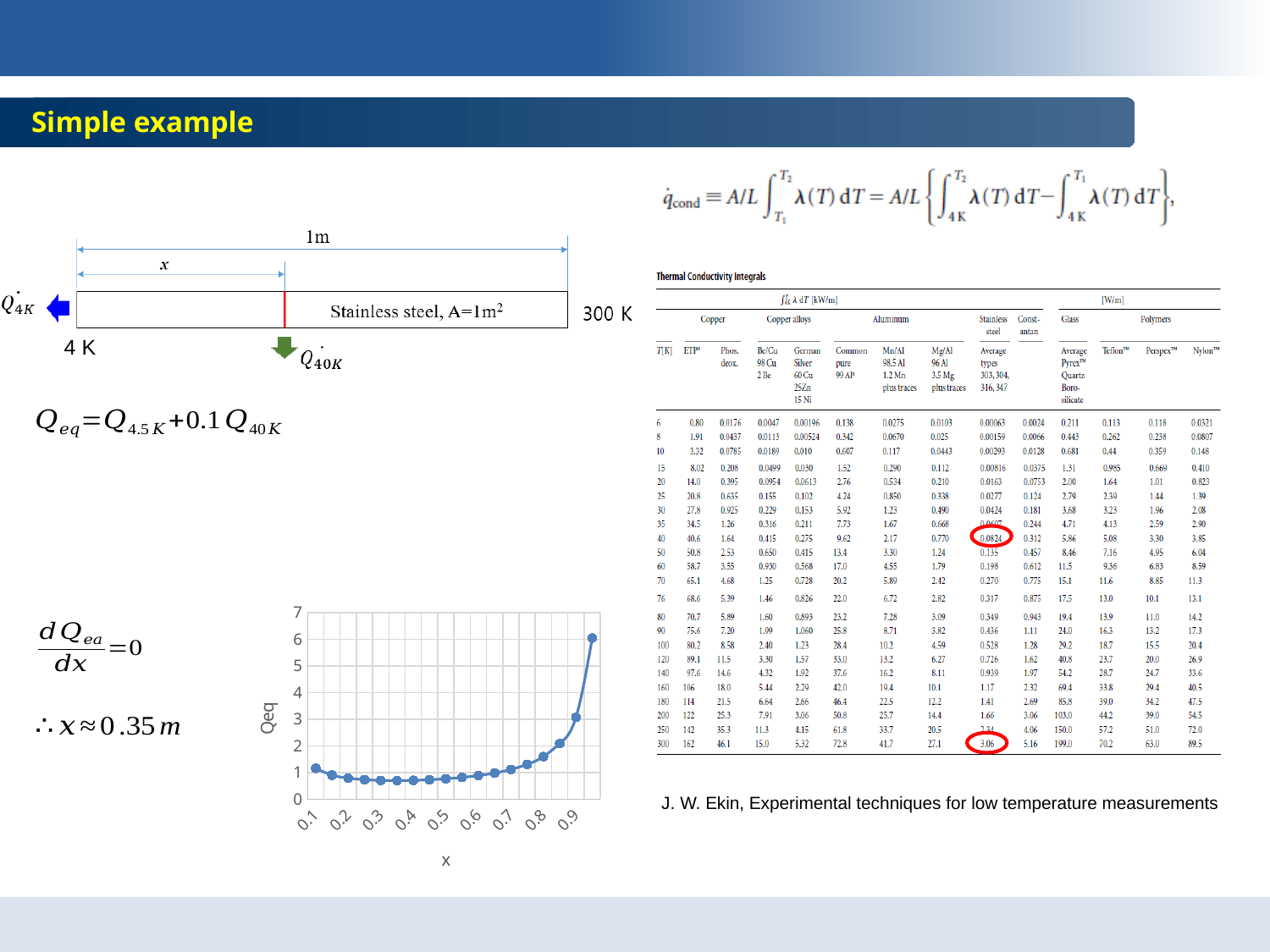
Is the value of Qeq at x = 0.1 greater or less than 2? less Is the value of Qeq at x = 0.5 greater or less than 1? less Which has the larger Qeq value, x = 0.1 or x = 0.9? x = 0.9 Is the value of Qeq at x = 0.8 greater or less than 2? less Do the Qeq values rise or fall as x goes from 0.5 to 0.9? rise Is the highest Qeq value at the left end or the right end of the x axis? right end What is the label of the x axis of the chart? x Do the Qeq values rise or fall as x goes from 0.1 to 0.3? fall What is the label of the y axis of the chart? Qeq What kind of chart is shown on the slide? line chart What is the highest tick value shown on the y axis of the chart? 7